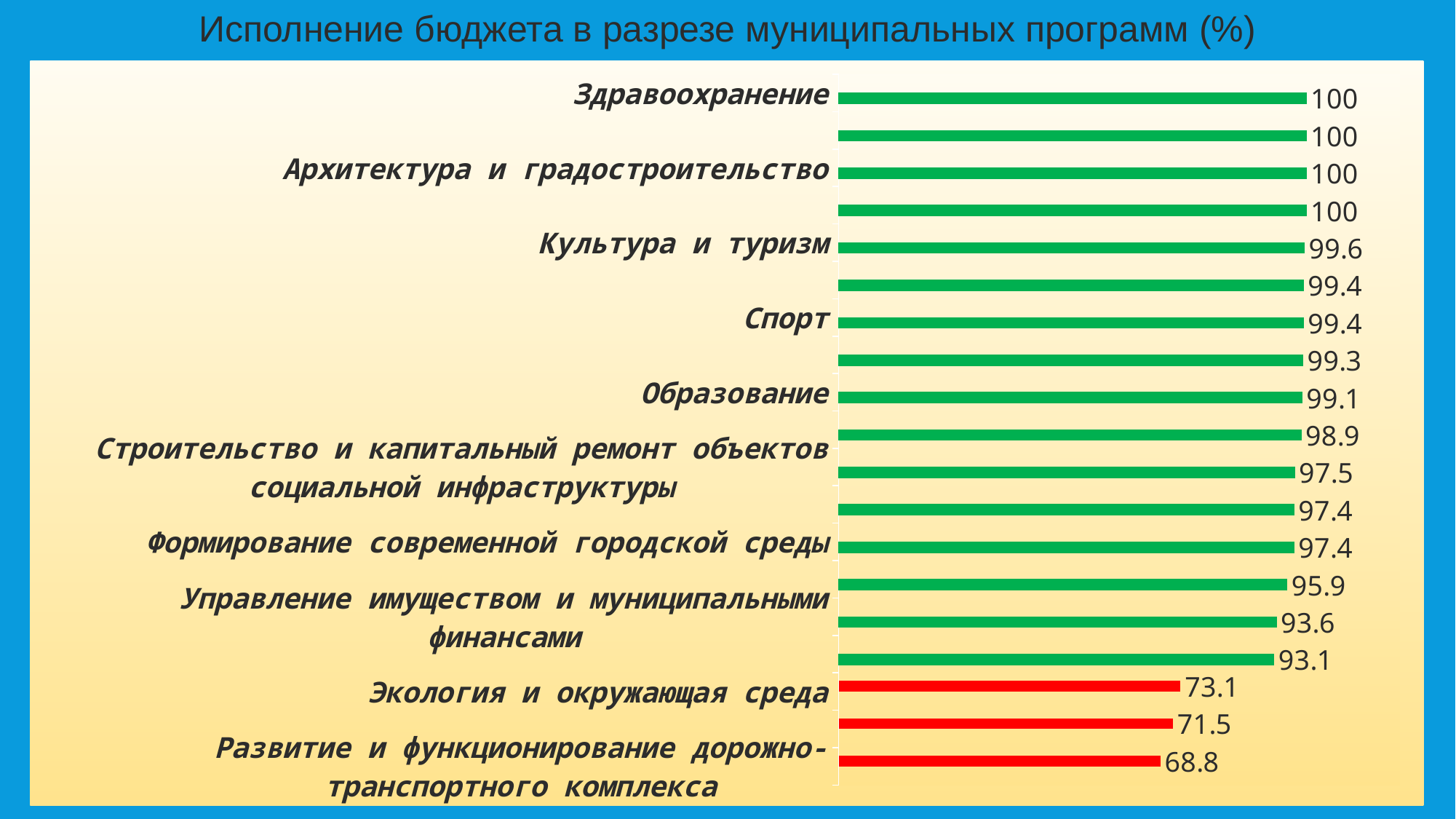
What is the value for Развитие и функционирование дорожно-транспортного комплекса? 68.8 What is the highest value shown on the chart? 100 What is the value for Образование? 99.1 What is the value for Культура и туризм? 99.6 Which is larger, the value for Спорт or the value for Образование? Спорт What type of chart is shown on the slide? bar chart What is the value for Спорт? 99.4 What is the difference between the values for Здравоохранение and Экология и окружающая среда? 26.9 Which labelled program has the lowest value? Развитие и функционирование дорожно-транспортного комплекса How many bars are shown in red? 3 What is the value for Здравоохранение? 100 What is the value for Экология и окружающая среда? 73.1